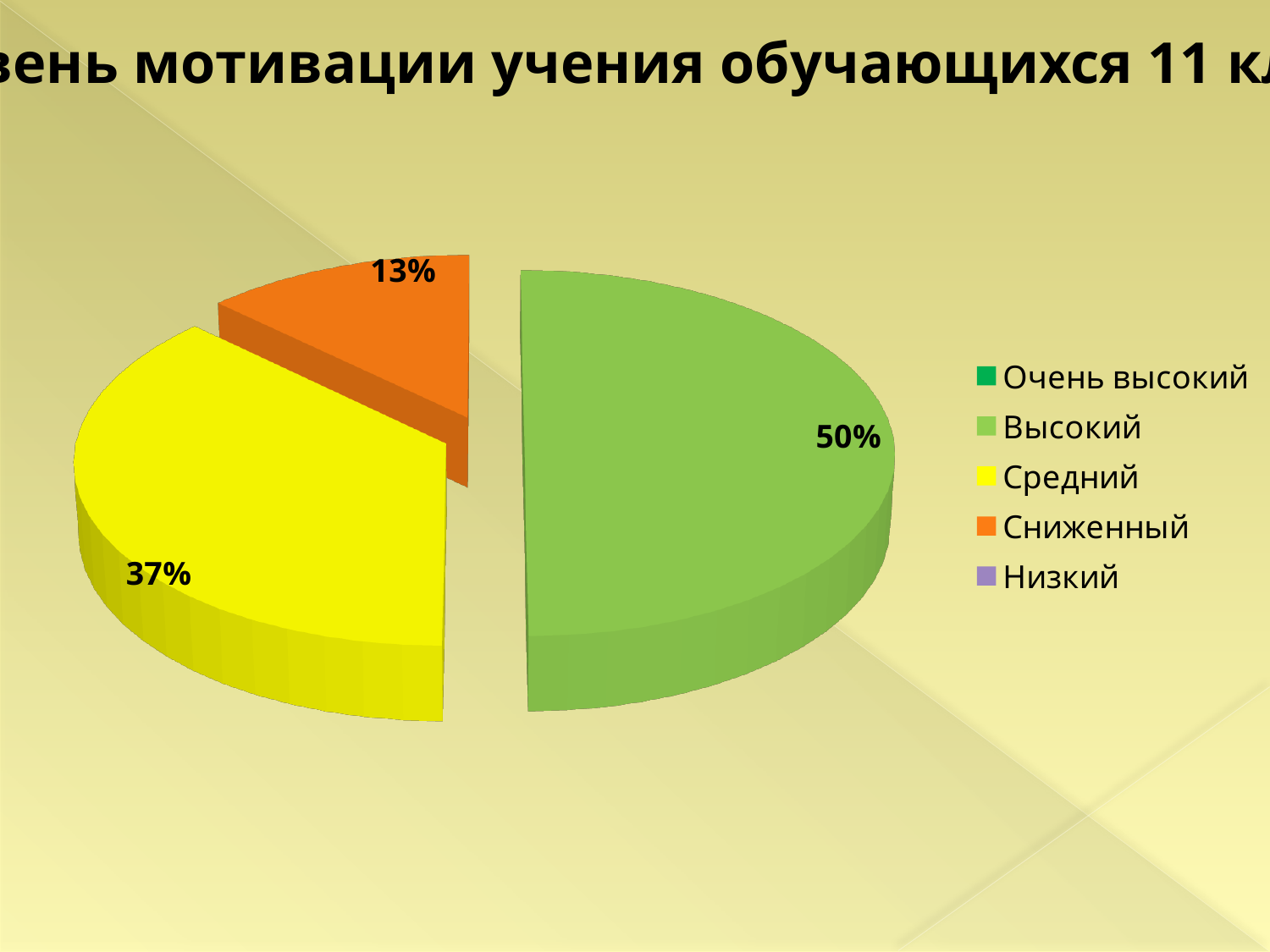
Which of the visible slices is the smallest? Сниженный What colour is the Средний slice? yellow What share of the pie does the Средний slice have? 37% Which is larger, the Средний slice or the Сниженный slice? Средний How many entries does the legend list? 5 What is the difference between the Высокий and Средний shares? 13% What share of the pie does the Высокий slice have? 50% How many slices with data labels are visible in the pie? 3 What is the difference between the Средний and Сниженный shares? 24% What share of the pie does the Сниженный slice have? 13% What kind of chart is shown on the slide? pie chart Which category has the largest slice of the pie? Высокий